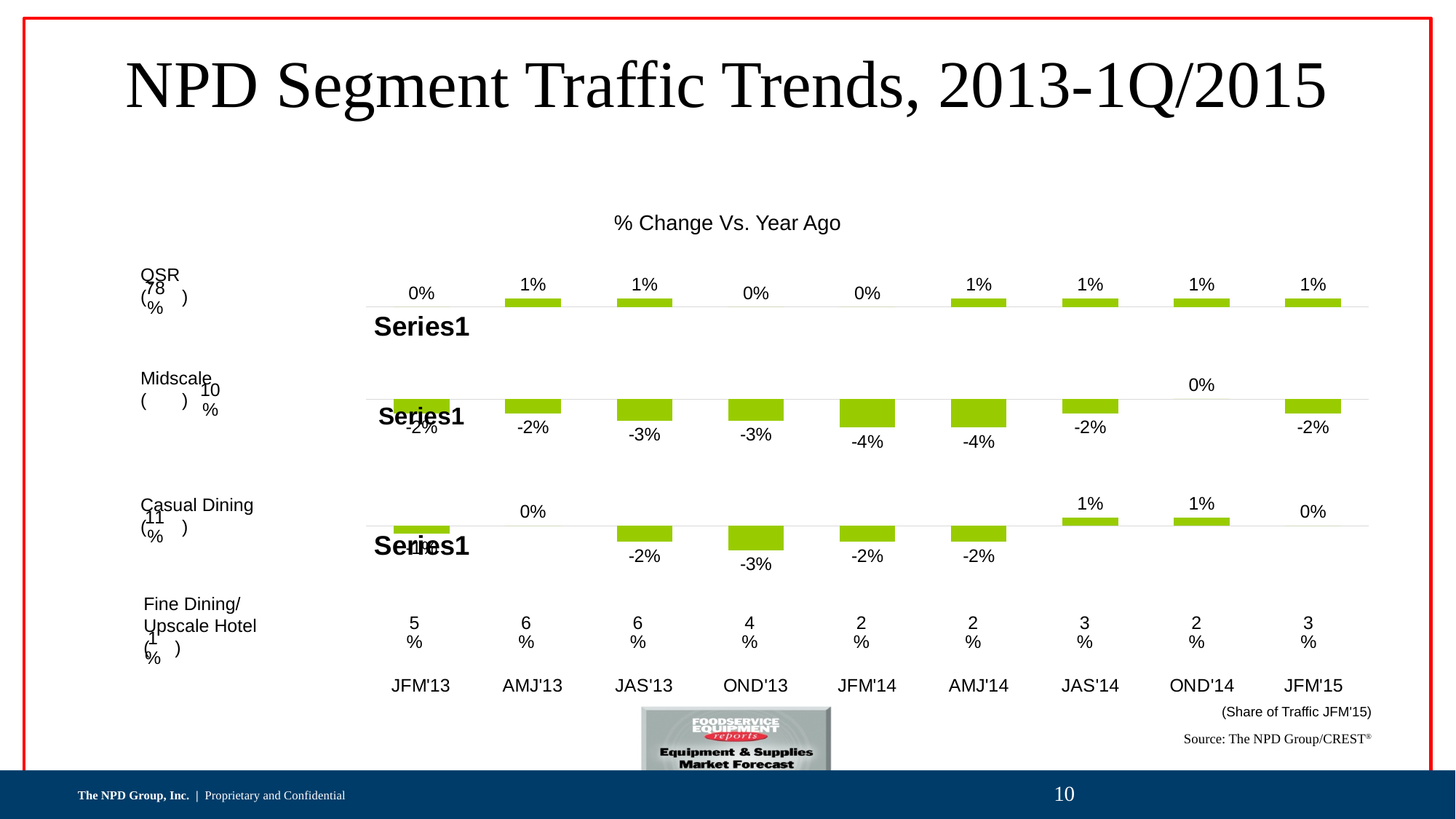
In the Midscale chart, what is the value for OND'14? 0% In the Casual Dining chart, what is the value for OND'13? -3% In the QSR chart, what is the % change vs. year ago for AMJ'13? 1% In the Midscale chart, what is the difference between the values for JAS'14 and JFM'14? 2% In the Casual Dining chart, which period has the lowest value? OND'13 In the Casual Dining chart, which is larger, the value for AMJ'13 or the value for JAS'13? AMJ'13 What is the subtitle shown above the charts? % Change Vs. Year Ago What type of chart is used for the Midscale segment? Bar chart In the Midscale chart, what is the value for JFM'14? -4% In the Midscale chart, which period has the highest value? OND'14 How many periods are shown along the x axis of the QSR chart? 9 In the Casual Dining chart, what is the value for JAS'14? 1%